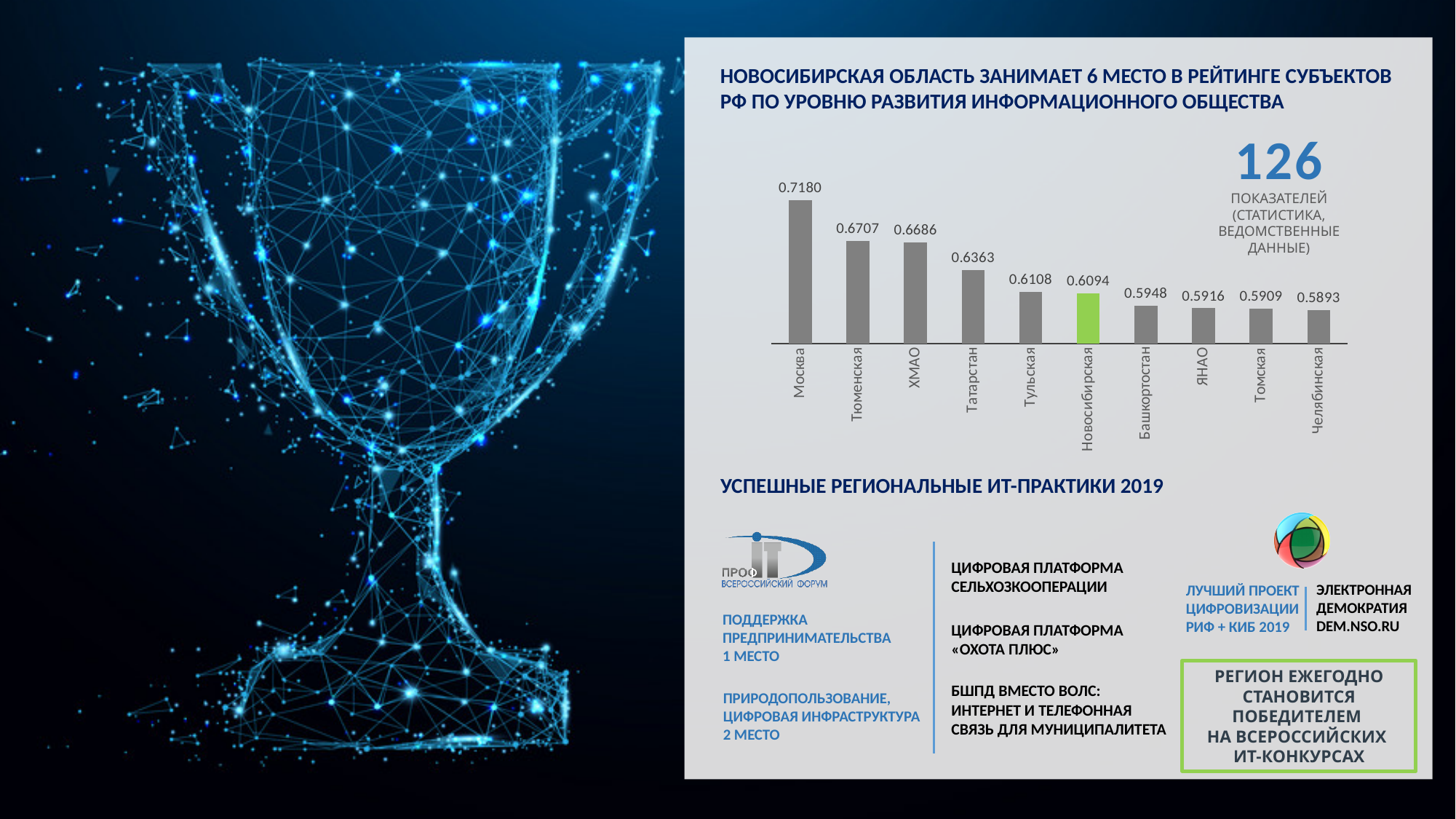
Which region's bar is highlighted in green? Новосибирская What is the difference between the values for Тюменская and ХМАО? 0.0021 What kind of chart is shown on the slide? Bar chart Which region has the highest value in the chart? Москва Which has a larger value, Татарстан or Башкортостан? Татарстан What value is shown for Новосибирская? 0.6094 Which region has the lowest value in the chart? Челябинская What value is shown for Татарстан? 0.6363 What value is shown for Москва? 0.7180 What value is shown for Челябинская? 0.5893 How many regions are shown in the chart? 10 What is the difference between the values for Москва and Новосибирская? 0.1086